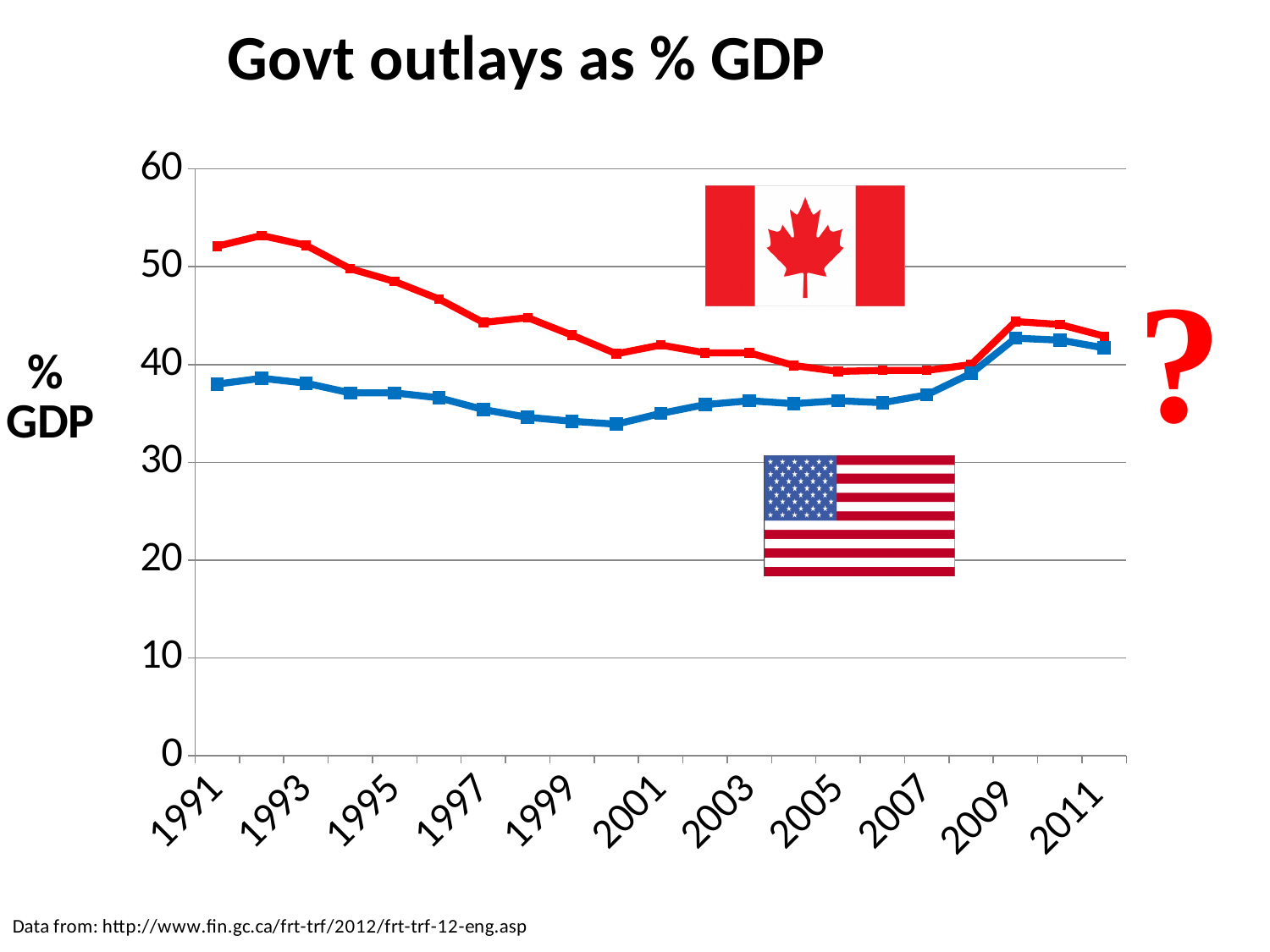
What is the title of the chart? Govt outlays as % GDP Is the value of the red line (Canada) in 1991 greater or less than 50? greater Does the blue line (US) rise or fall between 2001 and 2009? rise How many lines (series) are plotted on the chart? 2 What kind of chart is shown on the slide? line chart How many year labels are shown along the x axis? 11 Does the red line (Canada) rise or fall between 1991 and 2001? fall Is the value of the blue line (US) in 2009 greater or less than 40? greater Which line is higher in 1991, the red line (Canada) or the blue line (US)? the red line (Canada) Is the value of the blue line (US) in 1991 greater or less than 40? less What is the highest value shown on the y axis? 60